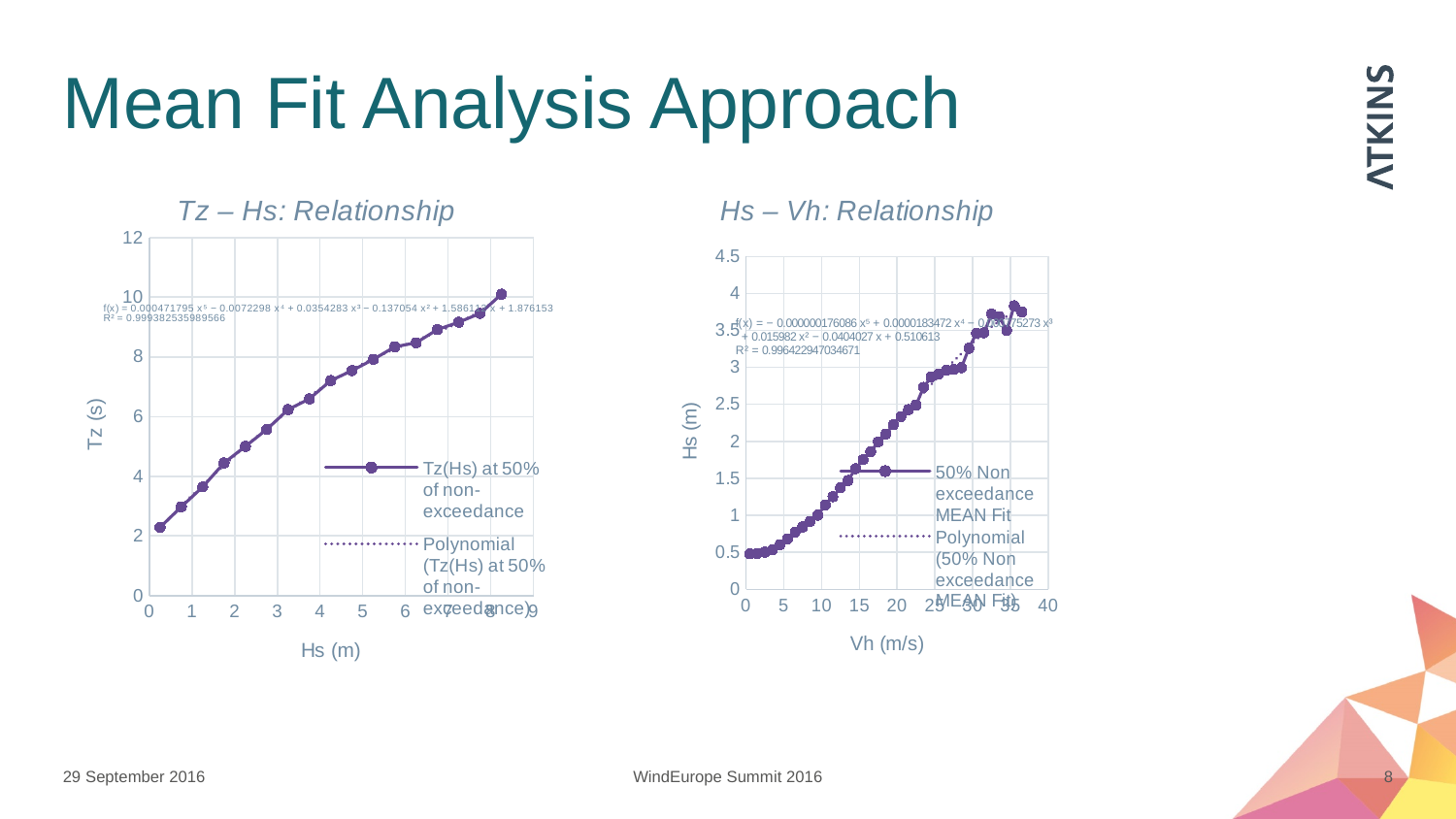
In the 'Tz – Hs: Relationship' chart, do the Tz values rise or fall as Hs increases? rise In the 'Hs – Vh: Relationship' chart, is the Hs value at Vh = 20 m/s greater or less than 2? greater What is the y-axis label of the 'Tz – Hs: Relationship' chart? Tz (s) In the 'Tz – Hs: Relationship' chart, is the Tz value at Hs = 2 m greater or less than 6? less What is the x-axis label of the 'Hs – Vh: Relationship' chart? Vh (m/s) How many series does the legend of the 'Hs – Vh: Relationship' chart list? 2 In the 'Tz – Hs: Relationship' chart, is the Tz value at Hs = 2 m greater or less than 4? greater How many series does the legend of the 'Tz – Hs: Relationship' chart list? 2 What kind of chart is the 'Tz – Hs: Relationship' chart? scatter chart In the 'Hs – Vh: Relationship' chart, do the Hs values rise or fall as Vh increases? rise